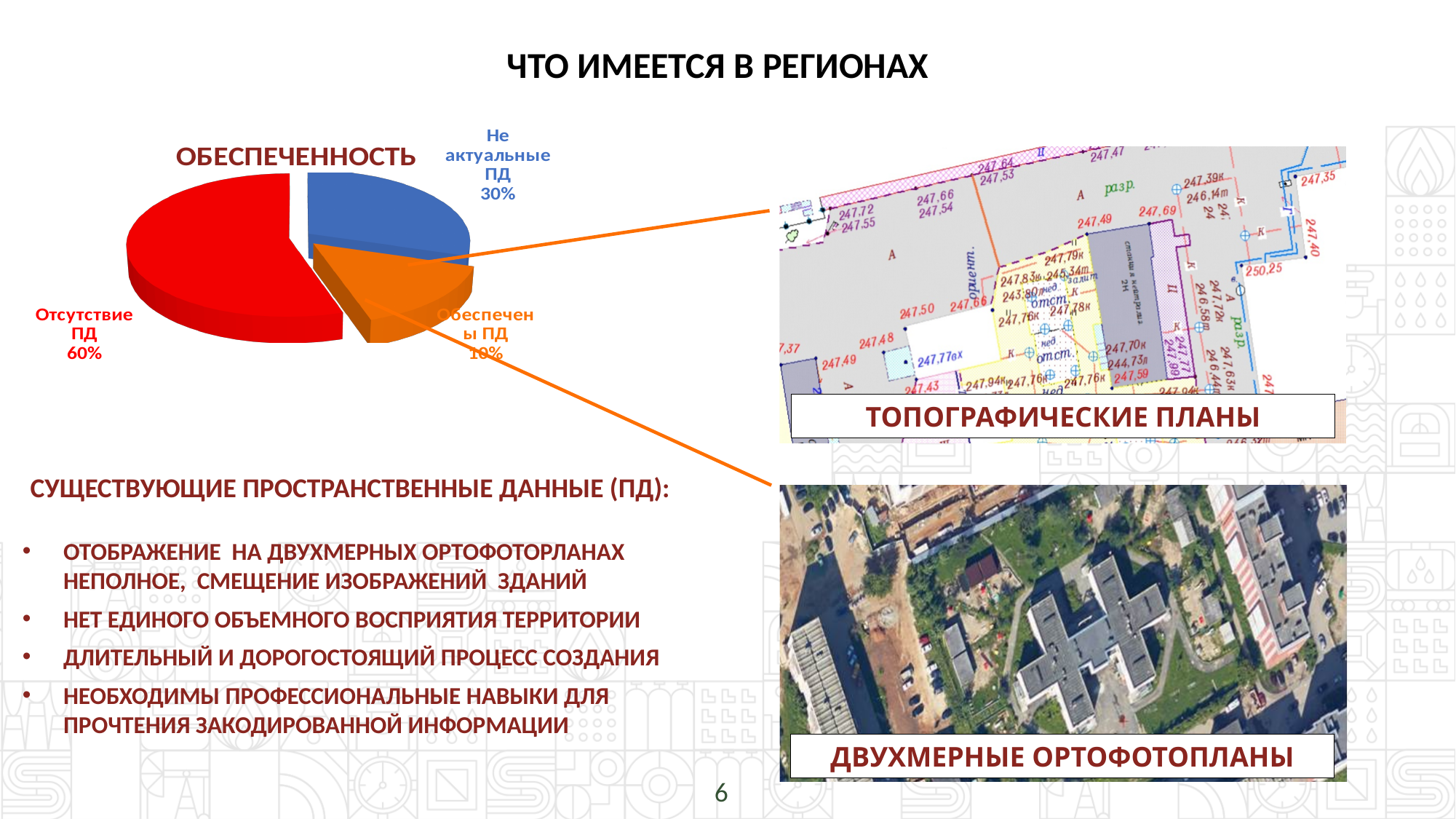
What is the difference in percentage points between "Отсутствие ПД" and "Не актуальные ПД"? 30 What share of the pie does "Обеспечены ПД" have? 10% How many slices does the pie chart have? 3 What colour is the "Отсутствие ПД" slice of the pie chart? Red Which slice of the pie chart is the largest? Отсутствие ПД What is the title of the pie chart? ОБЕСПЕЧЕННОСТЬ What share of the pie does "Отсутствие ПД" have? 60% Which slice of the pie chart is the smallest? Обеспечены ПД What kind of chart is shown on the slide? Pie chart What share of the pie does "Не актуальные ПД" have? 30% Which is larger: the share for "Не актуальные ПД" or the share for "Обеспечены ПД"? Не актуальные ПД What is the combined share of "Не актуальные ПД" and "Обеспечены ПД"? 40%